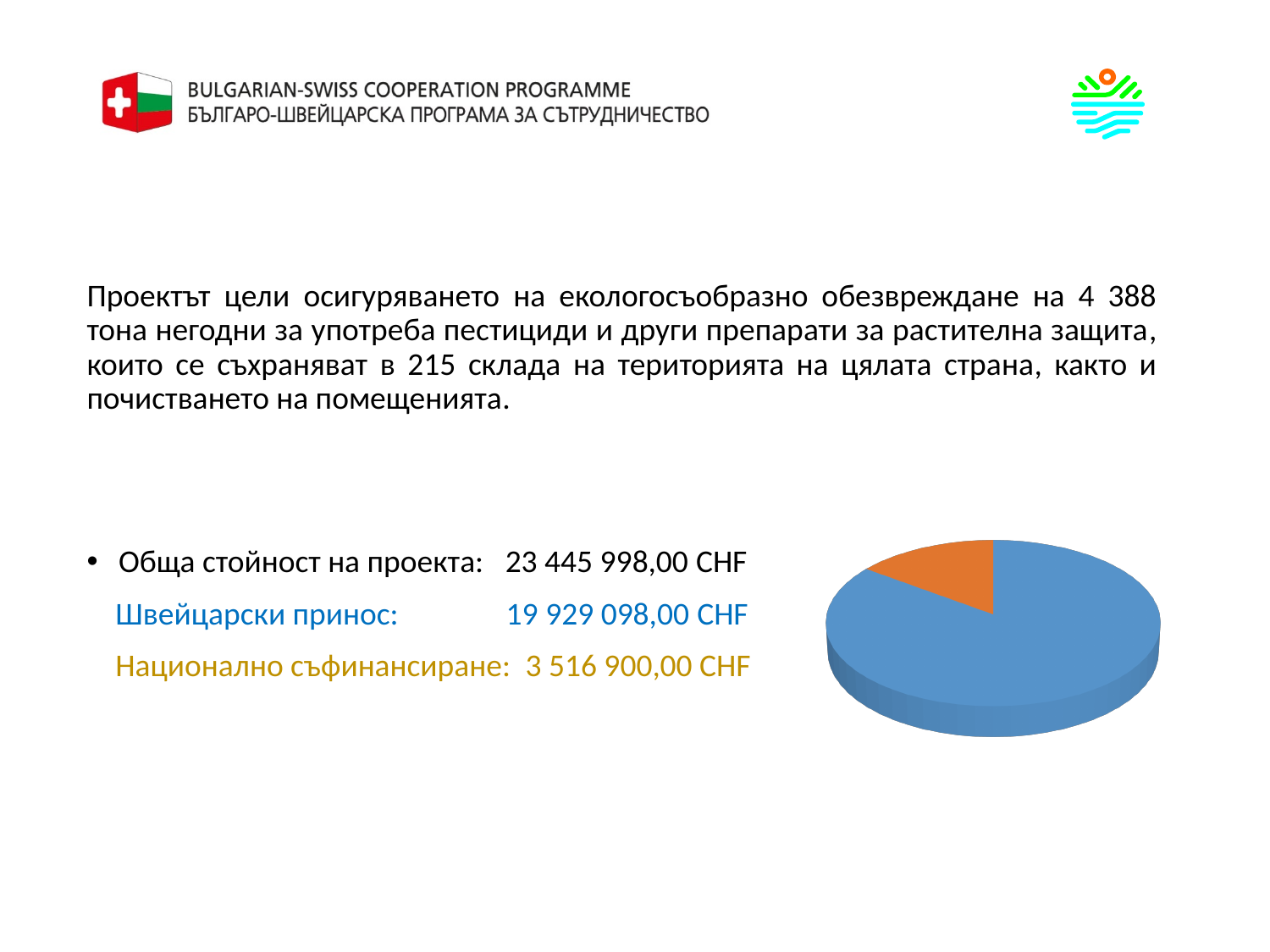
What colour is the smallest slice of the pie chart? orange What colour is the largest slice of the pie chart? blue Does the pie chart display a legend? No What kind of chart is shown on the slide? pie chart Does the orange slice take up more or less than half of the pie chart? less How many slices does the pie chart have? 2 Are data labels printed on the slices of the pie chart? No Which slice of the pie chart is larger, the blue one or the orange one? blue